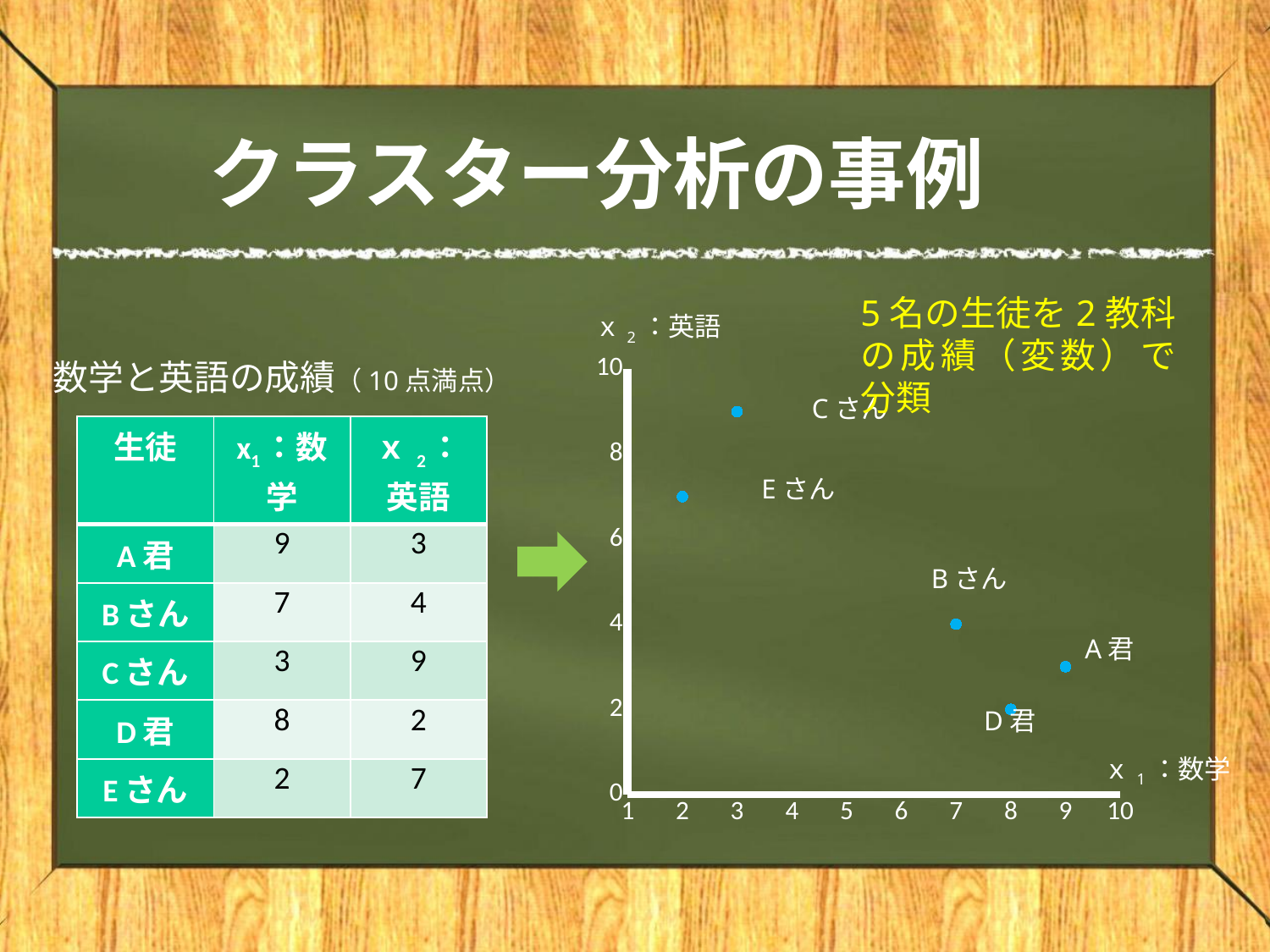
What is the 英語 (x2) score for Cさん on the chart? 9 What is the difference between the 数学 (x1) scores of A君 and Cさん? 6 What is the 数学 (x1) score for A君 on the chart? 9 Is the 数学 (x1) value for D君 greater or less than 6? greater How many students (points) are plotted on the scatter chart? 5 Which student has the highest 英語 (x2) score on the chart? Cさん Which student has the lowest 数学 (x1) score on the chart? Eさん What is the label of the horizontal axis of the chart? x1：数学 Which student has the lowest 英語 (x2) score on the chart? D君 What kind of chart is shown on the slide? scatter chart Who has the higher 英語 (x2) score, Bさん or Eさん? Eさん What is the 数学 (x1) score for Eさん on the chart? 2